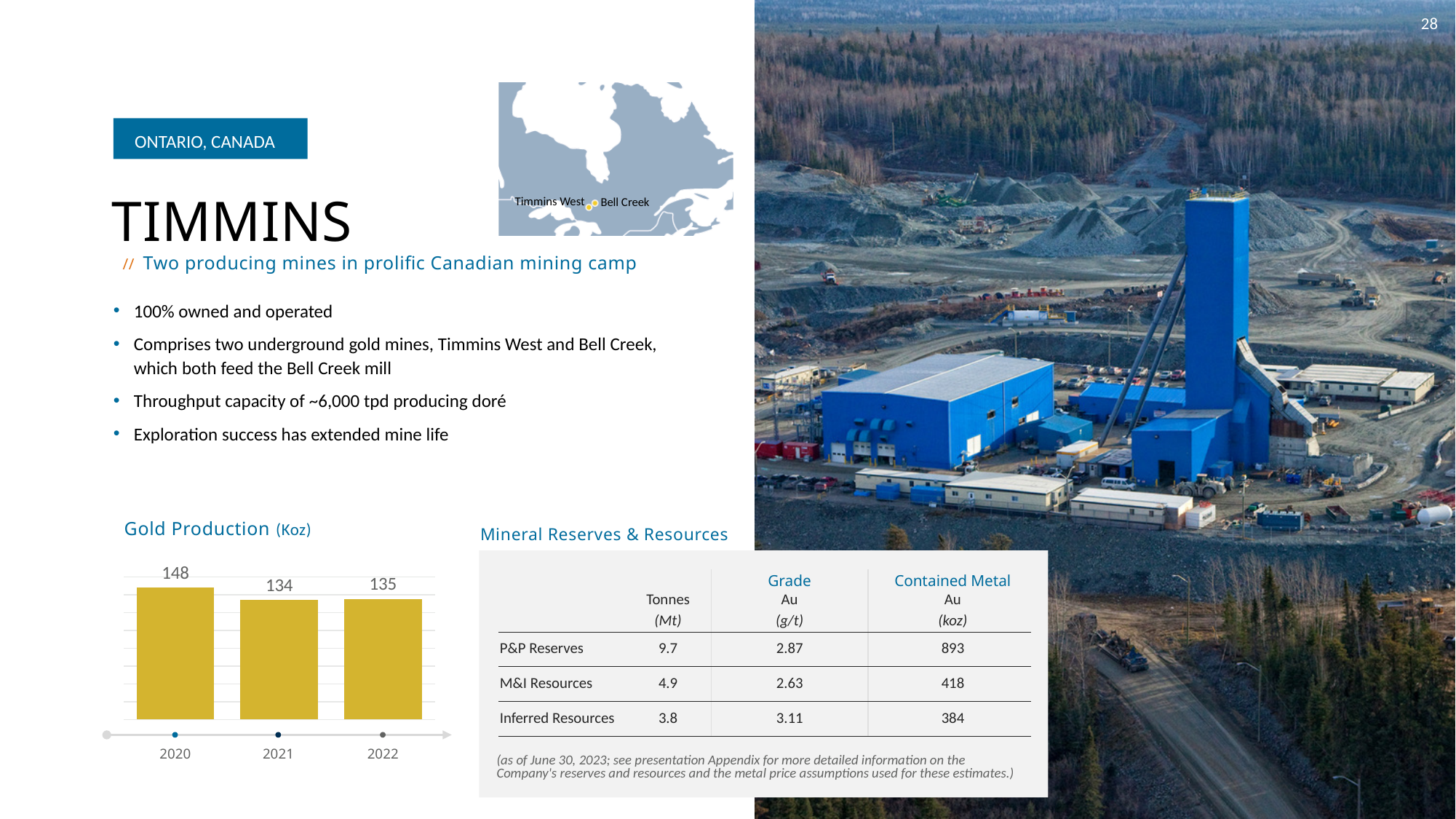
How many years are shown in the Gold Production chart? 3 What unit is gold production measured in on the Gold Production chart? Koz What was the gold production in 2021 according to the Gold Production chart? 134 Which year had the lowest gold production in the Gold Production chart? 2021 Which year had the highest gold production in the Gold Production chart? 2020 In the Gold Production chart, was gold production higher in 2020 or in 2022? 2020 What was the gold production in 2020 according to the Gold Production chart? 148 What was the gold production in 2022 according to the Gold Production chart? 135 Did gold production rise or fall from 2020 to 2021 in the Gold Production chart? Fall What is the difference in gold production between 2020 and 2021 in the Gold Production chart? 14 What type of chart is the Gold Production chart? Bar chart What is the difference in gold production between 2022 and 2021 in the Gold Production chart? 1